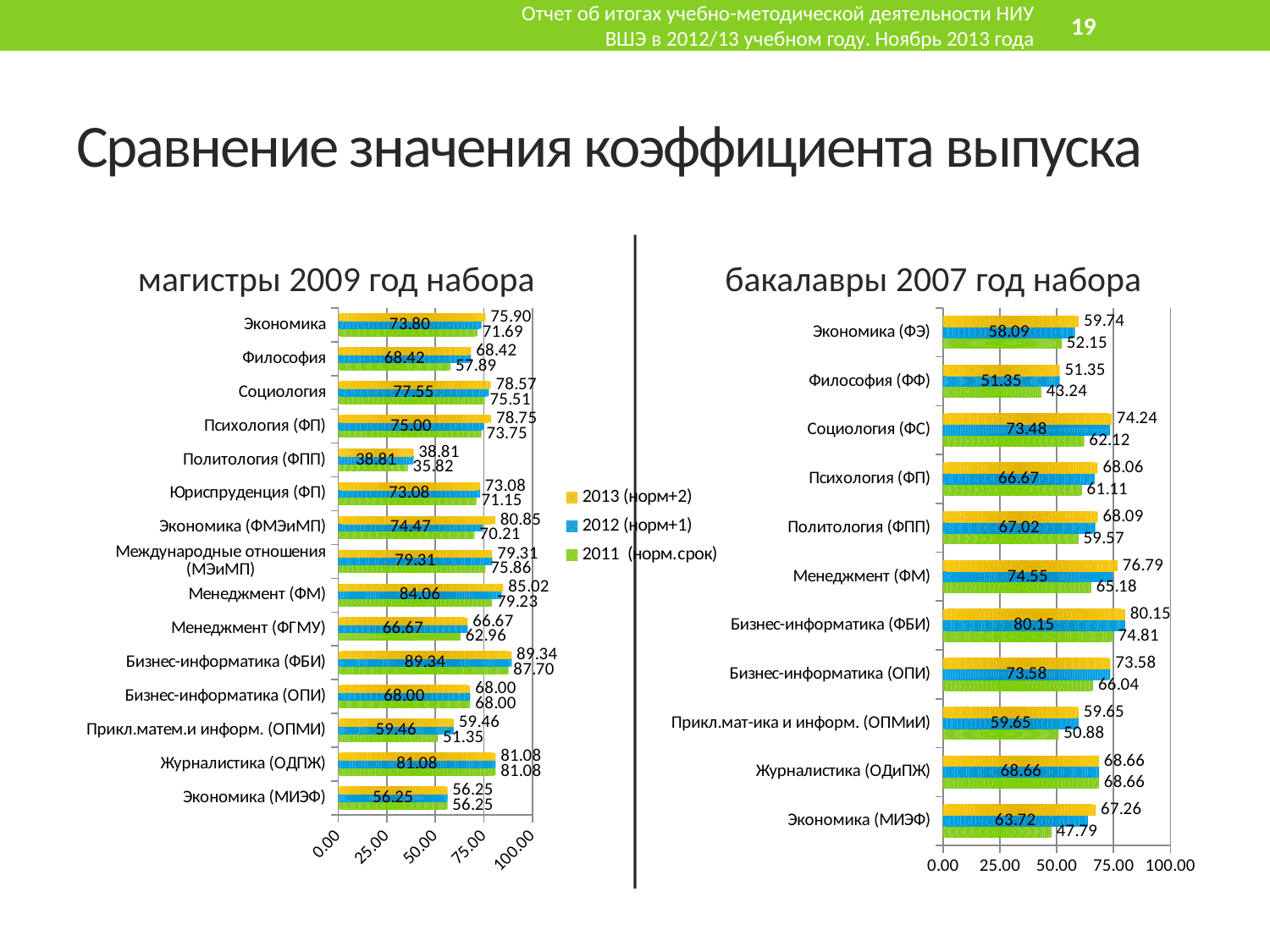
In the chart 'бакалавры 2007 год набора', which is larger in the 2013 (норм+2) series: Социология (ФС) or Психология (ФП)? Социология (ФС) What type of chart is used on this slide? Bar chart How many series does the legend list? 3 How many categories are shown in the chart 'бакалавры 2007 год набора'? 11 In the chart 'магистры 2009 год набора', what is the difference between the 2013 (норм+2) and 2011 (норм.срок) values for Философия? 10.53 In the chart 'бакалавры 2007 год набора', which category has the highest value in the 2012 (норм+1) series? Бизнес-информатика (ФБИ) In the chart 'бакалавры 2007 год набора', what is the value for Экономика (МИЭФ) in the 2011 (норм.срок) series? 47.79 In the chart 'магистры 2009 год набора', which category has the highest value in the 2013 (норм+2) series? Бизнес-информатика (ФБИ) How many categories are shown in the chart 'магистры 2009 год набора'? 15 In the chart 'магистры 2009 год набора', which category has the lowest value in the 2011 (норм.срок) series? Политология (ФПП) In the chart 'бакалавры 2007 год набора', what is the difference between the 2013 (норм+2) and 2011 (норм.срок) values for Философия (ФФ)? 8.11 In the chart 'магистры 2009 год набора', what is the value for Менеджмент (ФМ) in the 2013 (норм+2) series? 85.02